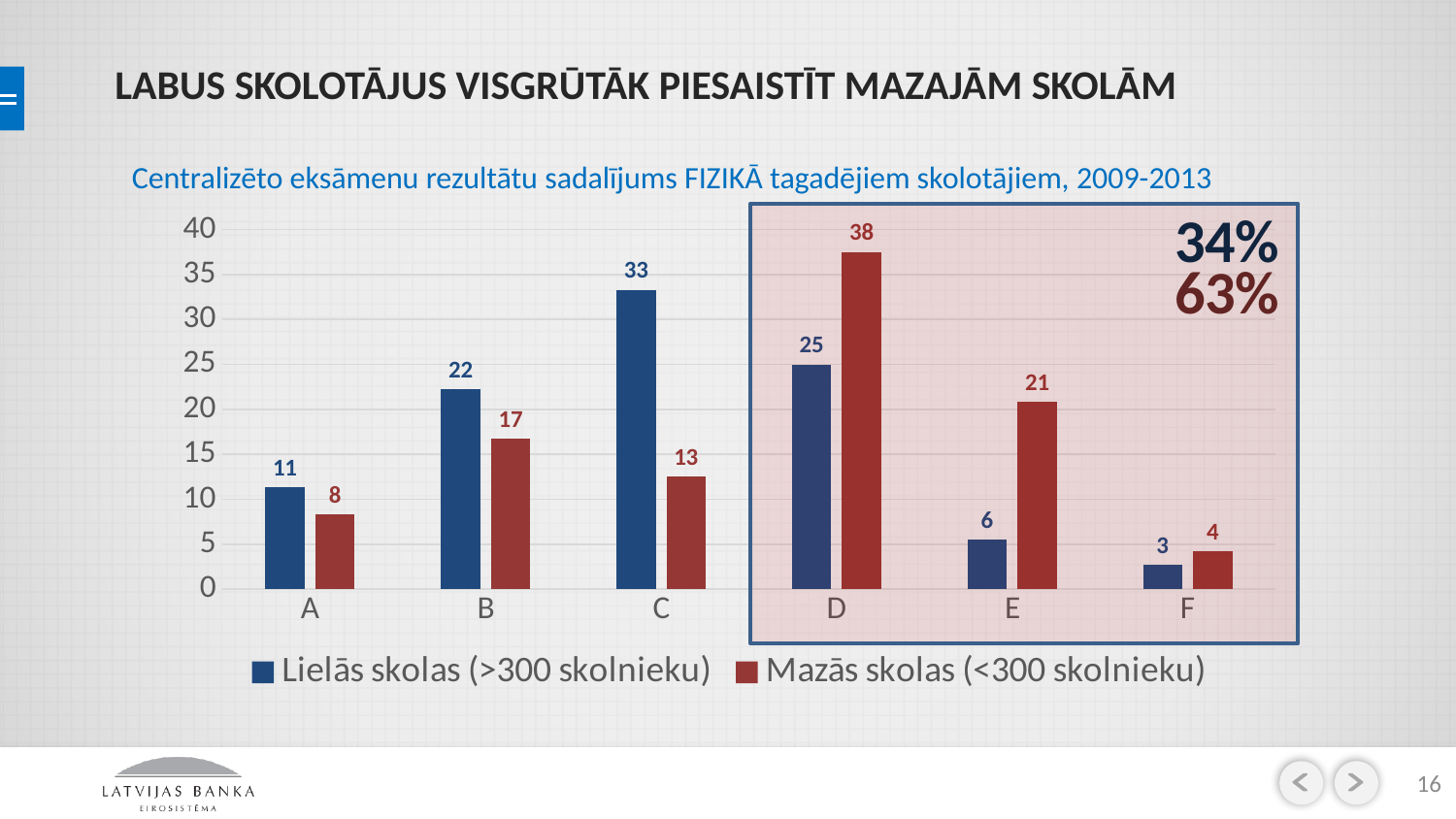
How many categories are shown on the x axis? 6 What is the title of the chart? Centralizēto eksāmenu rezultātu sadalījums FIZIKĀ tagadējiem skolotājiem, 2009-2013 For category C, which series has the larger value: Lielās skolas (>300 skolnieku) or Mazās skolas (<300 skolnieku)? Lielās skolas (>300 skolnieku) Which category has the lowest value in the Lielās skolas (>300 skolnieku) series? F What is the value for category D in the Mazās skolas (<300 skolnieku) series? 38 What is the value for category C in the Lielās skolas (>300 skolnieku) series? 33 What is the value for category E in the Lielās skolas (>300 skolnieku) series? 6 What is the difference between the Lielās skolas and Mazās skolas values for category B? 5 How many series does the legend list? 2 Which category has the highest value in the Mazās skolas (<300 skolnieku) series? D What kind of chart is shown on the slide? bar chart Is the value for category D in the Mazās skolas (<300 skolnieku) series greater or less than 35? greater